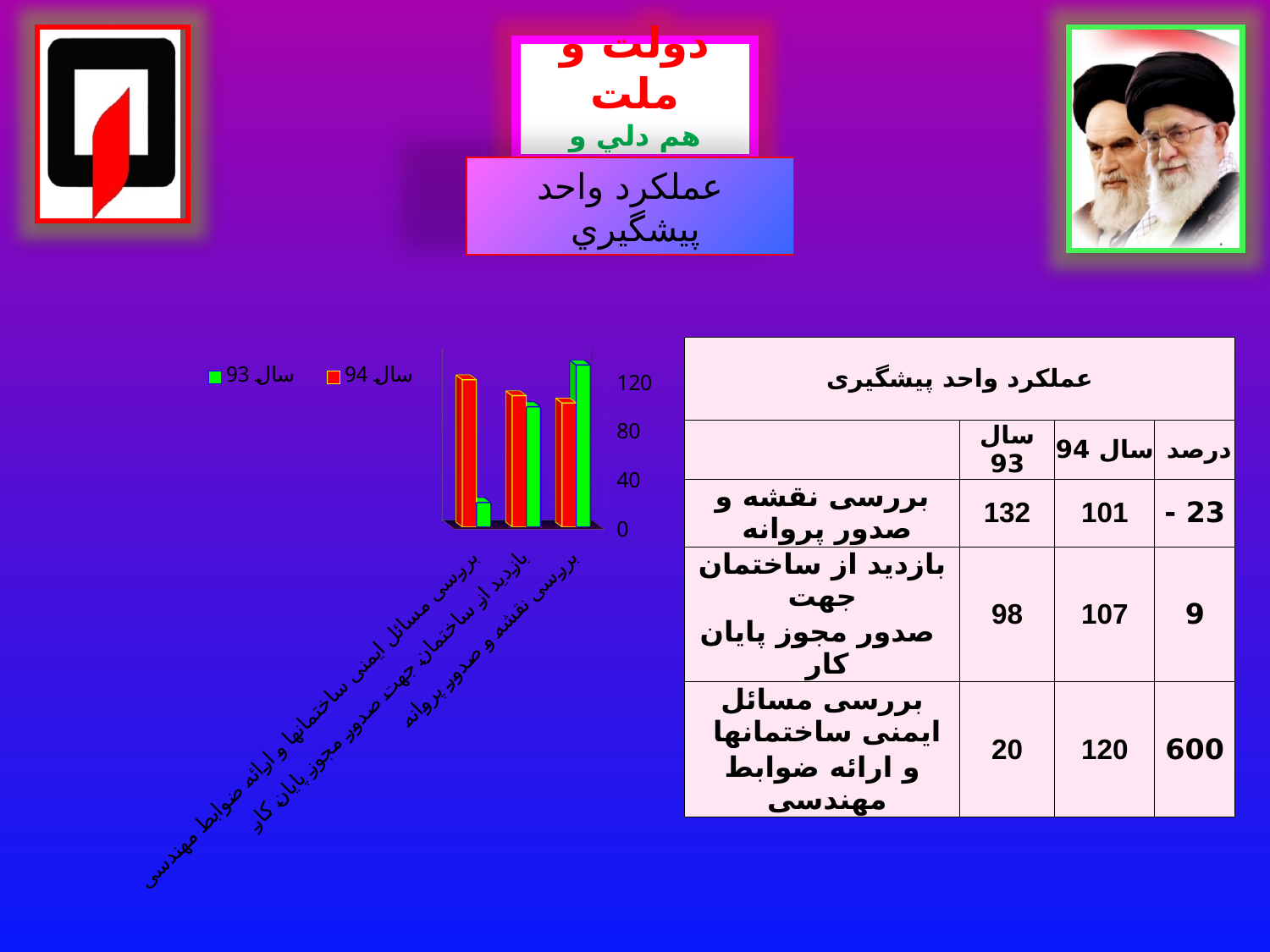
Is the سال 93 value for بررسی مسائل ایمنی ساختمانها و ارائه ضوابط مهندسی greater or less than 40? less For بررسی مسائل ایمنی ساختمانها و ارائه ضوابط مهندسی, which series has the larger bar, سال 93 or سال 94? سال 94 Which series is shown in red in the chart? سال 94 Which category has the lowest سال 93 bar in the chart? بررسی مسائل ایمنی ساختمانها و ارائه ضوابط مهندسی What kind of chart is shown on the slide? bar chart How many series does the chart legend list? 2 How many categories are plotted along the x axis of the chart? 3 Is the سال 94 value for بررسی مسائل ایمنی ساختمانها و ارائه ضوابط مهندسی greater or less than 80? greater Is the سال 93 value for بررسی نقشه و صدور پروانه greater or less than 80? greater For بررسی نقشه و صدور پروانه, which series has the larger bar, سال 93 or سال 94? سال 93 Which series is shown in green in the chart? سال 93